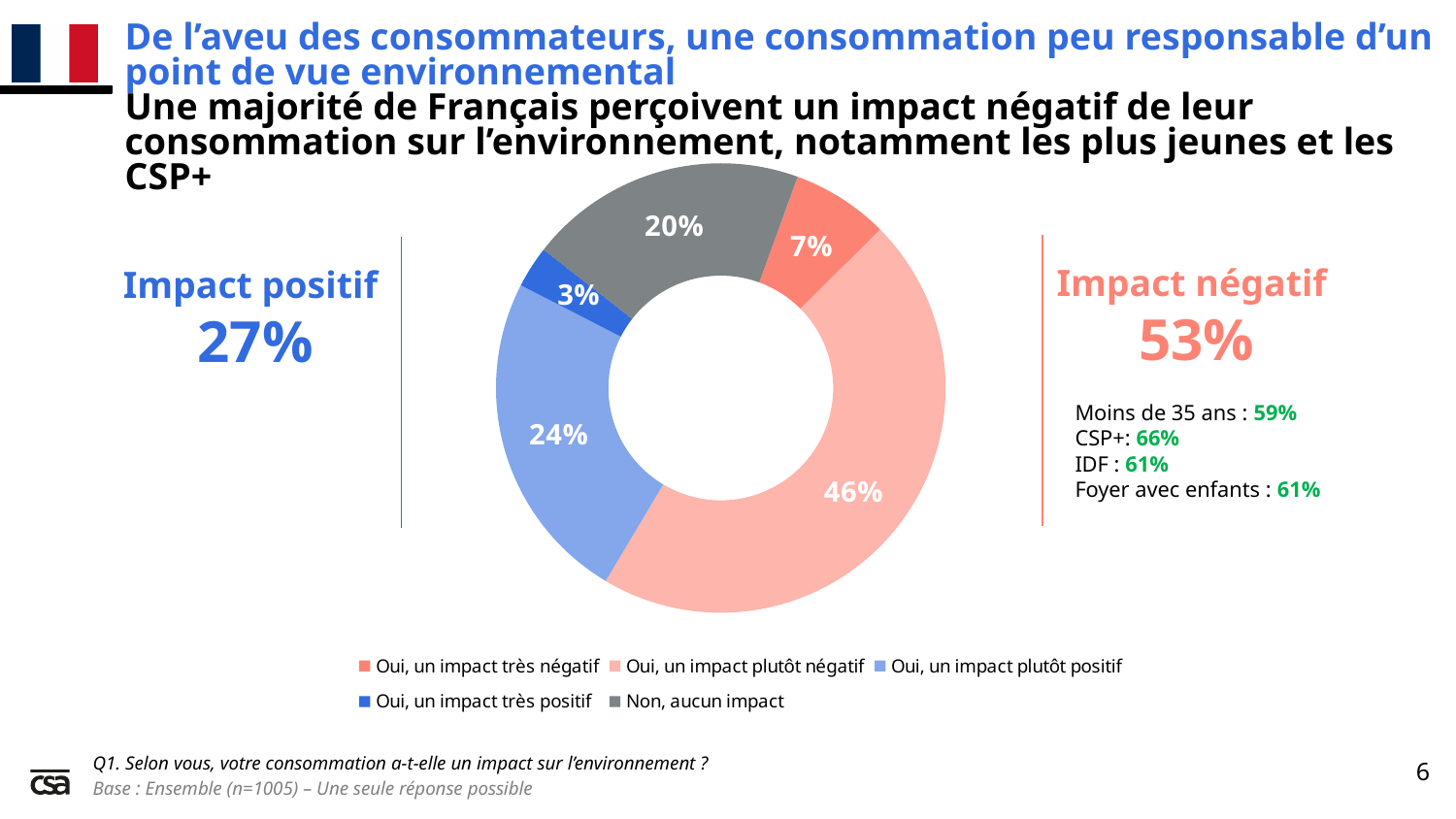
What percentage of respondents answered "Oui, un impact plutôt positif"? 24% How many response categories does the pie chart show? 5 Which is larger: the share for "Non, aucun impact" or the share for "Oui, un impact très négatif"? Non, aucun impact What is the difference between the share for "Oui, un impact plutôt négatif" and the share for "Oui, un impact plutôt positif"? 22 percentage points What percentage of respondents answered "Oui, un impact très négatif"? 7% What kind of chart is shown on the slide? Pie chart (donut) What percentage of respondents answered "Oui, un impact plutôt négatif"? 46% Which response has the smallest share of the pie? Oui, un impact très positif What colour is the slice for "Non, aucun impact"? Grey What percentage of respondents answered "Non, aucun impact"? 20% What percentage of respondents answered "Oui, un impact très positif"? 3% Which response has the largest share of the pie? Oui, un impact plutôt négatif